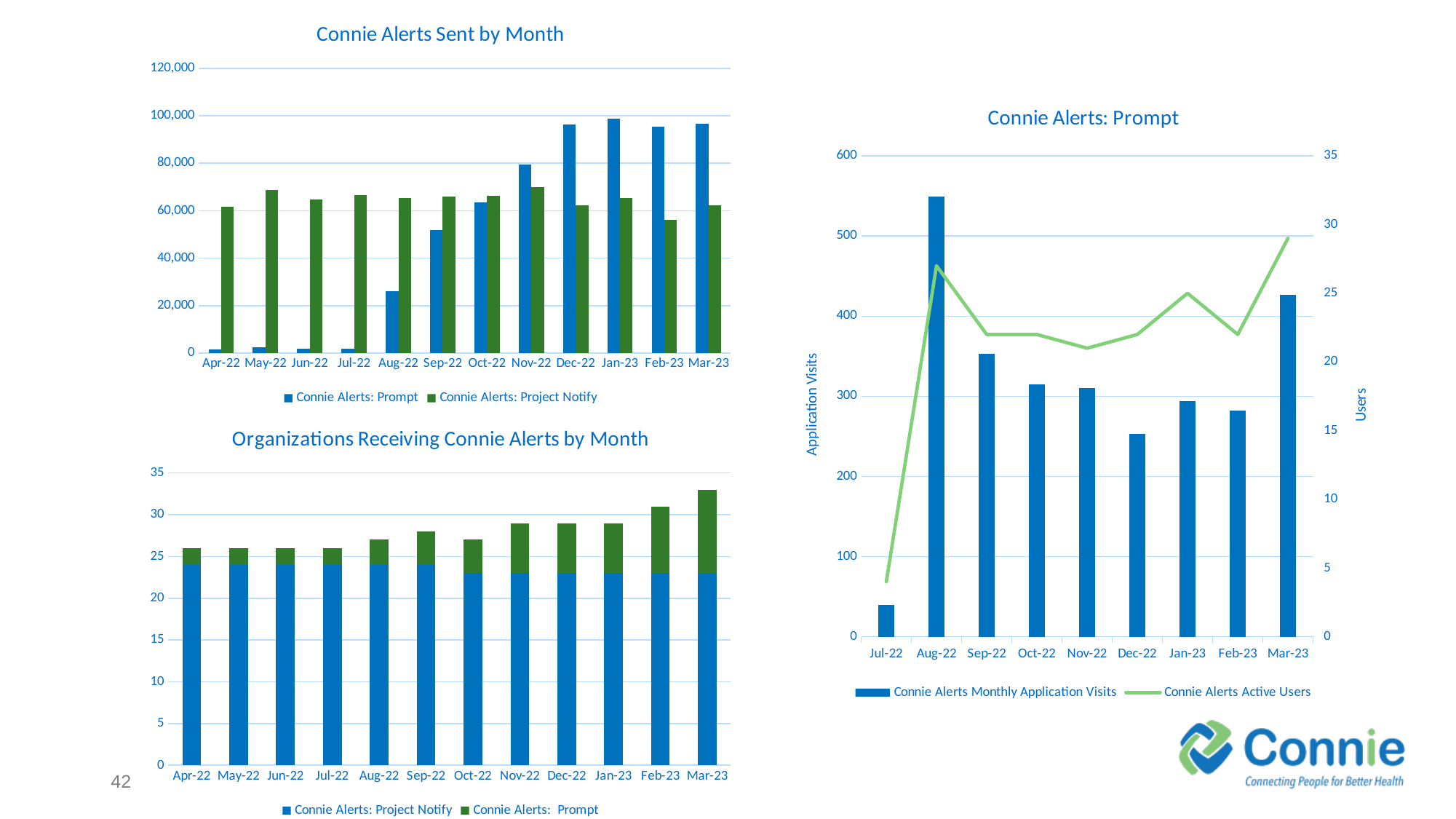
In the 'Connie Alerts Sent by Month' chart, how many months are shown on the x axis? 12 In the 'Connie Alerts: Prompt' chart, which month has the highest number of Connie Alerts Monthly Application Visits? Aug-22 In the 'Connie Alerts Sent by Month' chart, is the Connie Alerts: Project Notify value for Feb-23 greater or less than 60,000? less In the 'Connie Alerts Sent by Month' chart, do the Connie Alerts: Prompt values generally rise or fall from Apr-22 to Jan-23? rise In the 'Organizations Receiving Connie Alerts by Month' chart, how many series does the legend list? 2 In the 'Connie Alerts Sent by Month' chart, which month has the highest value for Connie Alerts: Prompt? Jan-23 In the 'Connie Alerts: Prompt' chart, is the Connie Alerts Monthly Application Visits value for Aug-22 greater or less than 500? greater In the 'Connie Alerts Sent by Month' chart, which is larger for Aug-22: Connie Alerts: Prompt or Connie Alerts: Project Notify? Connie Alerts: Project Notify In the 'Connie Alerts: Prompt' chart, which month has the lowest number of Connie Alerts Monthly Application Visits? Jul-22 In the 'Organizations Receiving Connie Alerts by Month' chart, is the total for Mar-23 greater or less than 30? greater In the 'Organizations Receiving Connie Alerts by Month' chart, which month has the tallest stacked bar? Mar-23